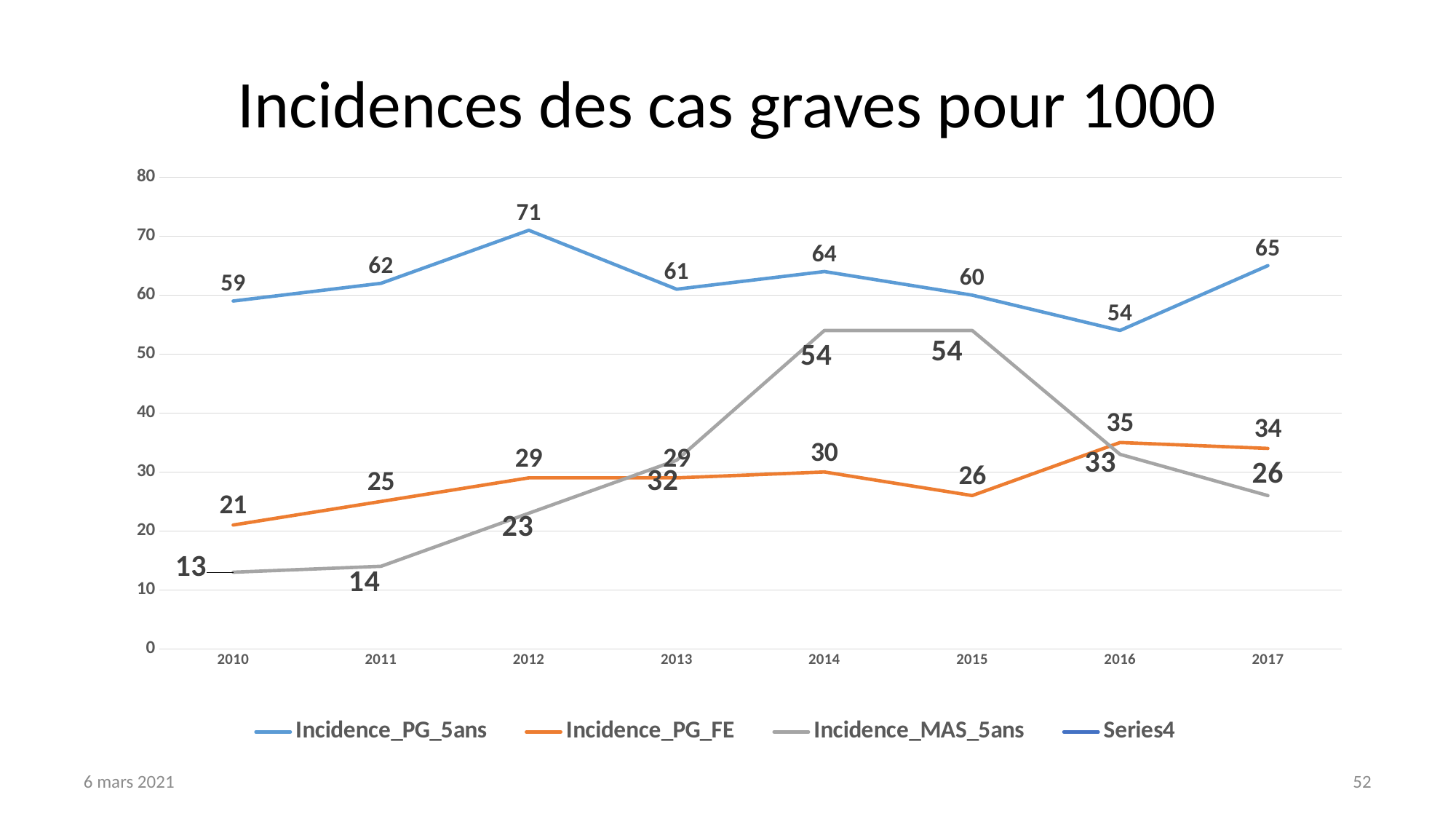
How many years are shown on the x axis? 8 In which year is Incidence_MAS_5ans lowest? 2010 How many series does the legend list? 4 What is the value of Incidence_PG_5ans in 2012? 71 What is the title of the chart? Incidences des cas graves pour 1000 What is the difference between Incidence_PG_5ans and Incidence_PG_FE in 2010? 38 Does Incidence_MAS_5ans rise or fall from 2010 to 2014? rise What is the value of Incidence_MAS_5ans in 2014? 54 In which year is Incidence_PG_5ans highest? 2012 What is the value of Incidence_PG_FE in 2016? 35 What type of chart is shown on the slide? line chart Which is larger in 2013, Incidence_PG_FE or Incidence_MAS_5ans? Incidence_MAS_5ans